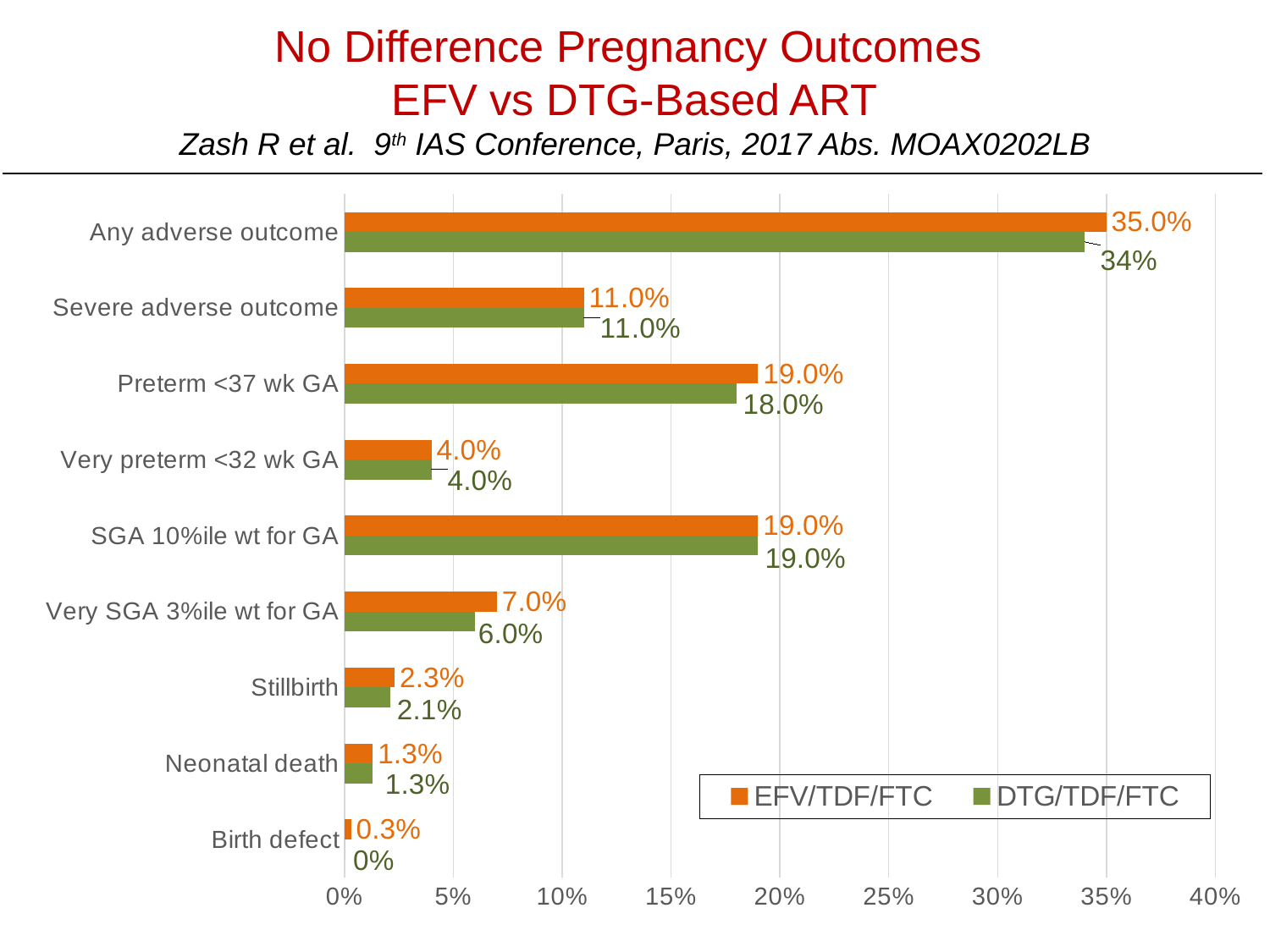
What is the value for EFV/TDF/FTC for Birth defect? 0.3% What is the value for DTG/TDF/FTC for Stillbirth? 2.1% What is the value for DTG/TDF/FTC for Preterm <37 wk GA? 18.0% What is the difference between the EFV/TDF/FTC and DTG/TDF/FTC values for Very SGA 3%ile wt for GA? 1.0% Which category has the highest value for DTG/TDF/FTC? Any adverse outcome Which category has the lowest value for EFV/TDF/FTC? Birth defect What is the value for EFV/TDF/FTC for Any adverse outcome? 35.0% How many series does the legend list? 2 What kind of chart is shown on the slide? Bar chart Which is larger for Any adverse outcome: EFV/TDF/FTC or DTG/TDF/FTC? EFV/TDF/FTC Is the EFV/TDF/FTC value for Severe adverse outcome greater or less than 10%? greater How many outcome categories are shown on the chart? 9